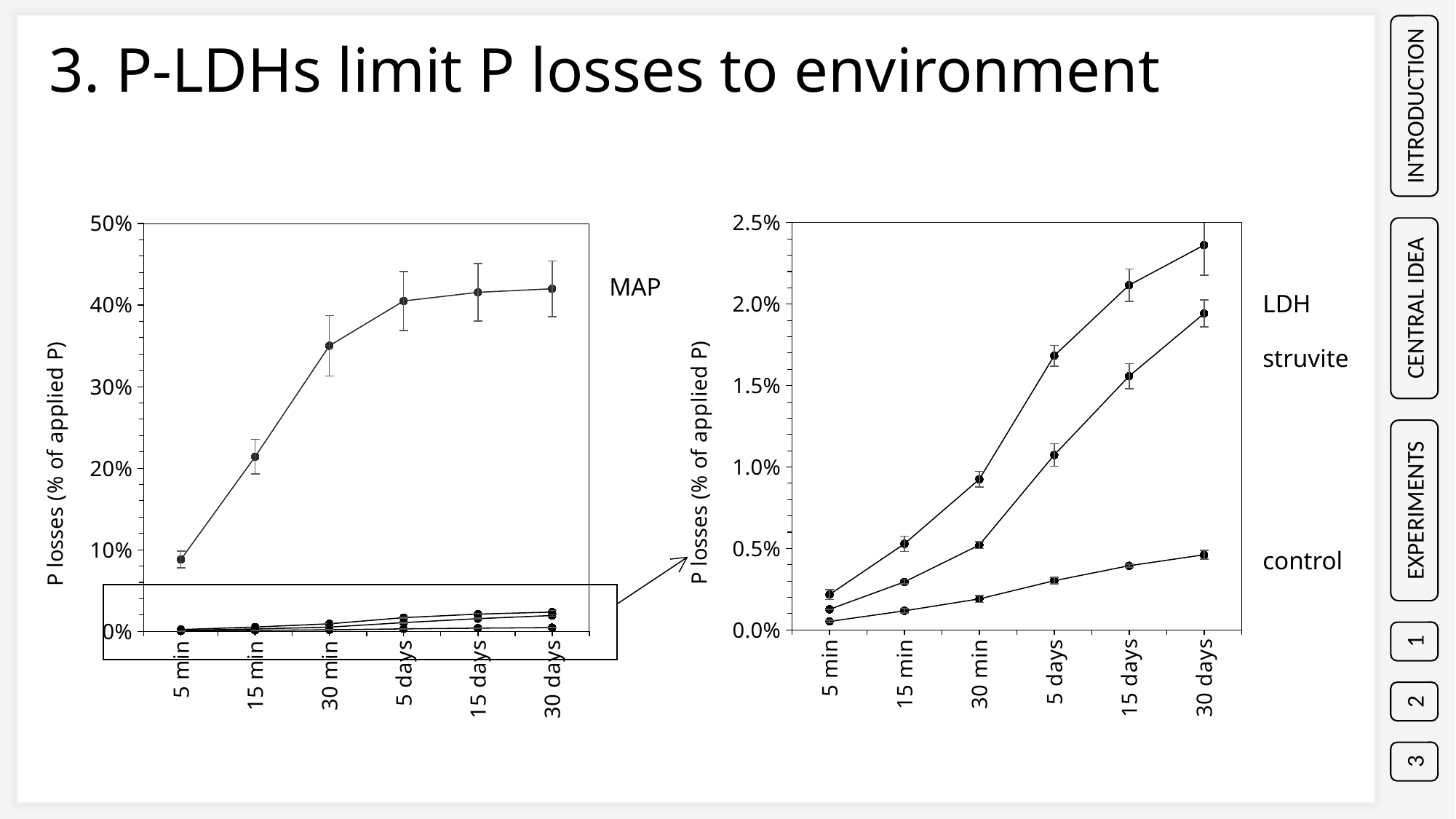
On the left chart, is the value for MAP at 30 min greater or less than 30%? greater On the right chart, which series has the lowest value at 30 days? control On the right chart, is the value for control at 5 days greater or less than 0.5%? less On the left chart, does the MAP series rise or fall from 5 min to 30 days? rise On the right chart, which series has the highest value at 30 days? LDH What is the y-axis label of the right chart? P losses (% of applied P) On the right chart, is the value for LDH at 30 days greater or less than 2.0%? greater On the right chart, at 30 min, which is larger: LDH or struvite? LDH On the left chart, how many time points are shown on the x axis? 6 On the right chart (y-axis 0.0% to 2.5%), how many series are labeled? 3 What kind of chart is the left chart (y-axis 0% to 50%)? line chart